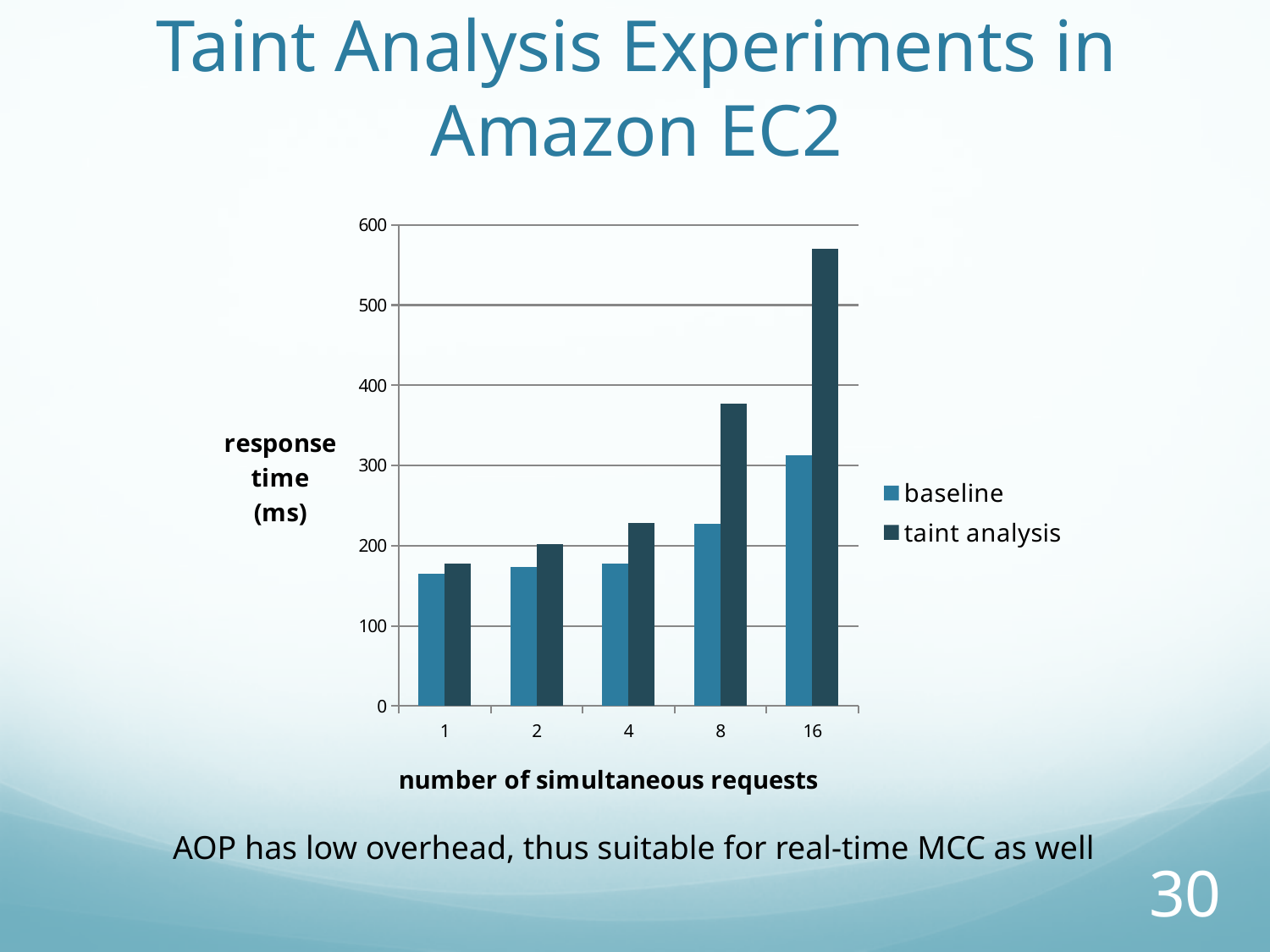
Is the taint analysis response time at 8 simultaneous requests greater or less than 300? greater At 16 simultaneous requests, which is larger: the baseline or the taint analysis response time? taint analysis How many categories of number of simultaneous requests are shown on the x axis? 5 Is the baseline response time at 1 simultaneous request greater or less than 200? less What is the label of the y axis? response time (ms) At which number of simultaneous requests is the baseline response time lowest? 1 Which series has the highest bar in the chart, and at which number of simultaneous requests? taint analysis at 16 What kind of chart is shown on the slide? bar chart Is the baseline response time at 16 simultaneous requests greater or less than 400? less Does the taint analysis response time rise or fall as the number of simultaneous requests increases? rise How many series does the legend list? 2